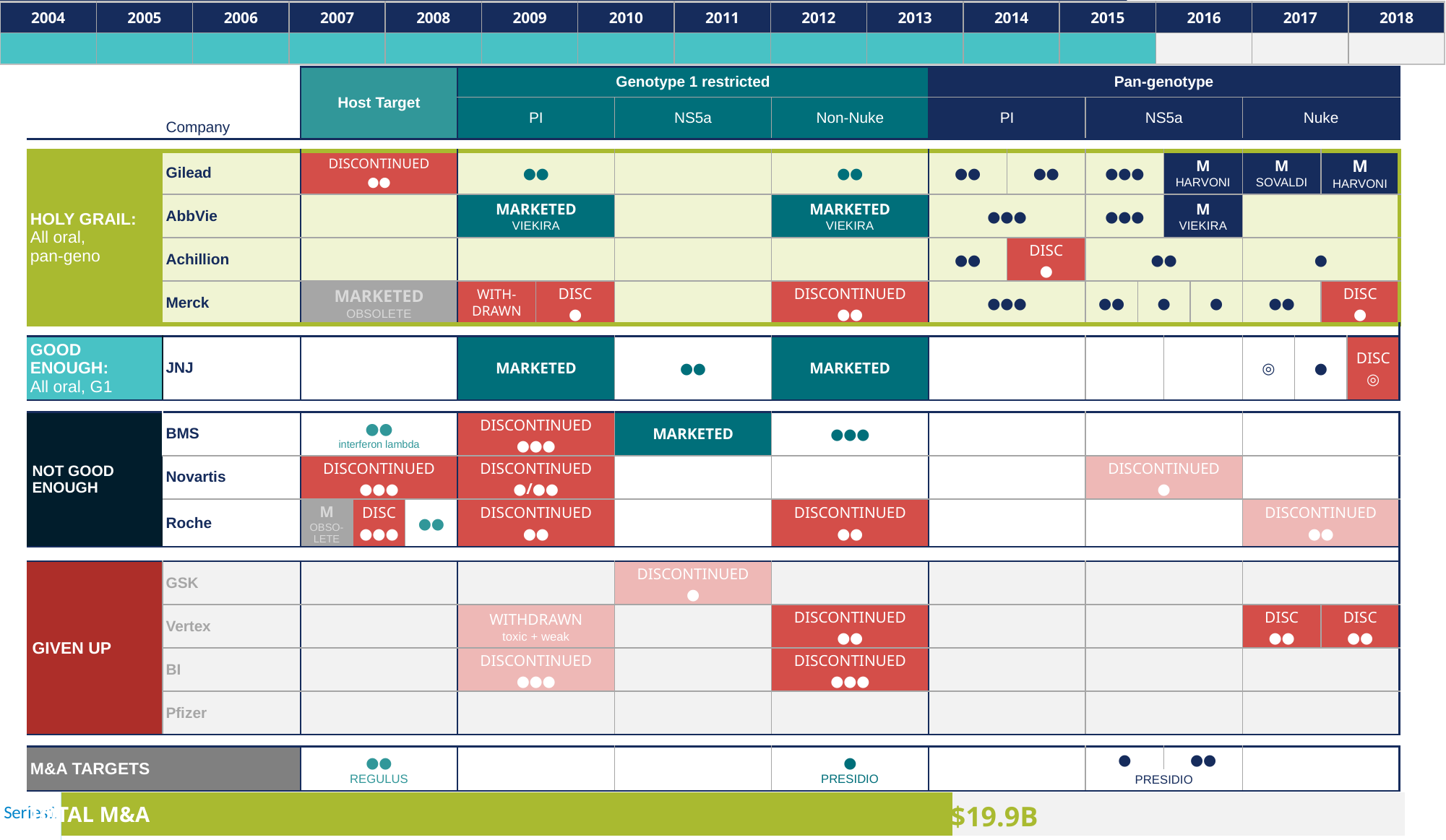
What kind of chart is the TOTAL M&A graphic at the bottom of the slide? bar chart In the bar at the bottom of the slide labelled TOTAL M&A, what value is printed on the bar? $19.9B In the timeline bar across the top of the slide, what is the last year shown? 2018 How many bars are plotted in the TOTAL M&A bar chart at the bottom of the slide? 2 In the timeline bar across the top of the slide, what is the first year shown? 2004 How many year columns are shown in the timeline bar across the top of the slide? 15 In the timeline bar across the top of the slide, through which year does the teal filled bar extend? 2015 What series name is shown at the left of the TOTAL M&A bar chart at the bottom of the slide? Series1